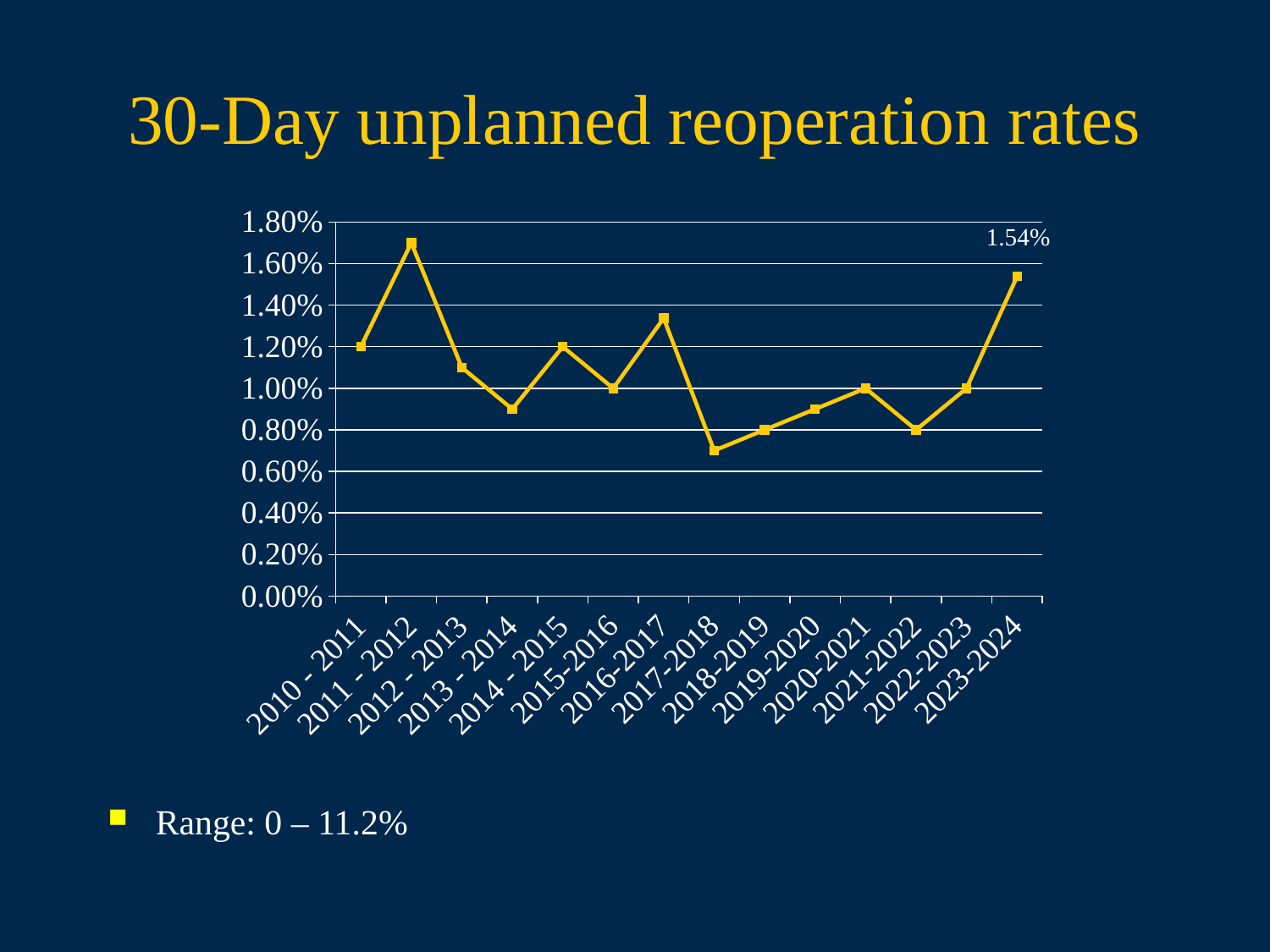
Which period has the lowest 30-day unplanned reoperation rate? 2017-2018 Is the reoperation rate for 2016-2017 greater or less than 1.20%? greater Is the reoperation rate for 2013 - 2014 greater or less than 1.00%? less What kind of chart is shown on the slide? Line chart Is the reoperation rate for 2017-2018 greater or less than 0.80%? less Does the reoperation rate rise or fall from 2021-2022 to 2023-2024? Rise Which period has the highest 30-day unplanned reoperation rate? 2011 - 2012 How many periods are plotted on the chart? 14 Which period has a higher reoperation rate, 2011 - 2012 or 2023-2024? 2011 - 2012 Which period has a higher reoperation rate, 2016-2017 or 2017-2018? 2016-2017 What is the 30-day unplanned reoperation rate for 2023-2024? 1.54%